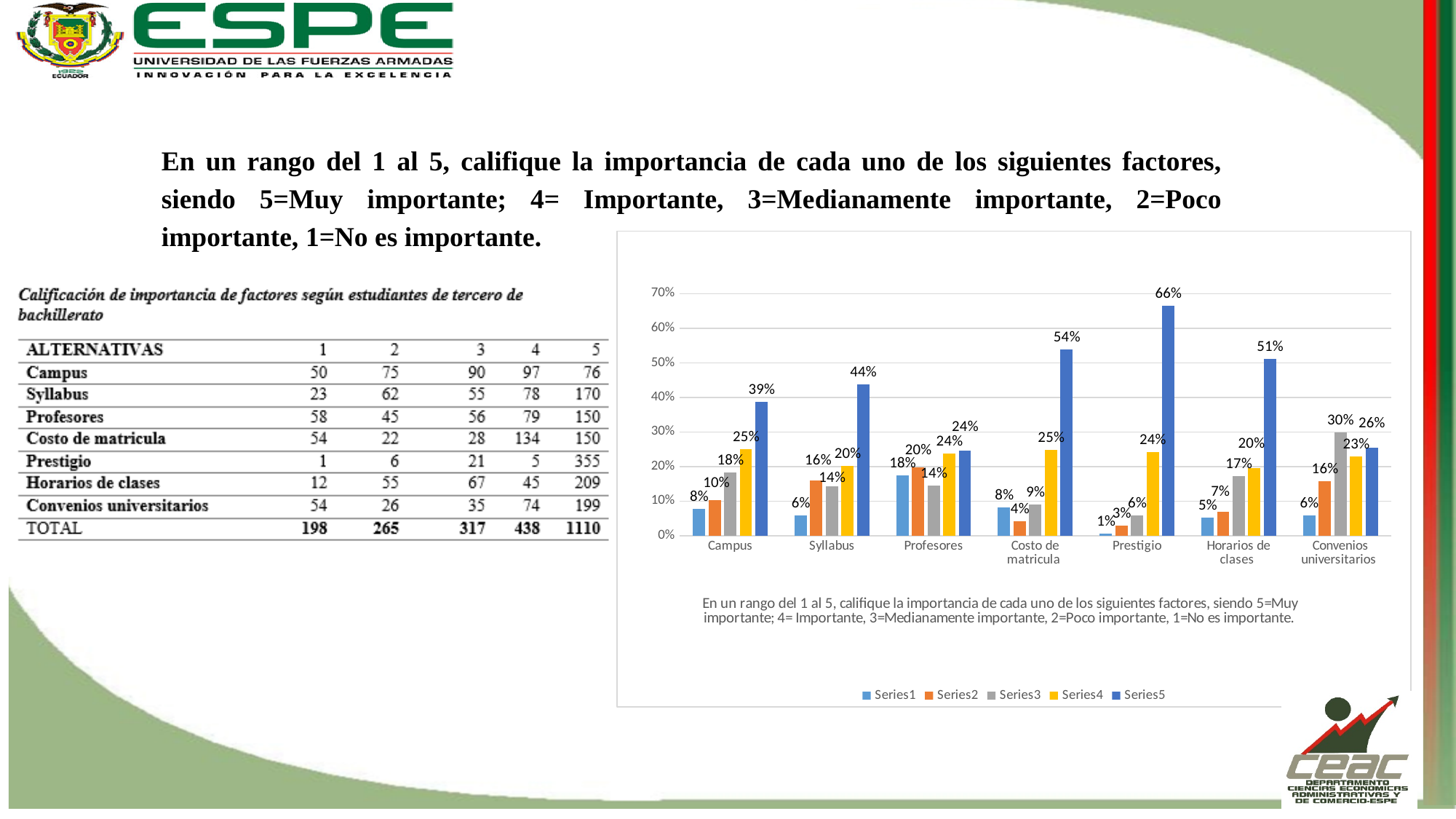
What is the value of Series5 for Prestigio? 66% Which is larger: Series5 for Syllabus or Series5 for Horarios de clases? Horarios de clases What is the difference between the Series5 values for Costo de matricula and Campus? 15% What is the value of Series3 for Convenios universitarios? 30% Which category has the lowest Series1 value? Prestigio Which category has the highest Series5 value? Prestigio Is the Series5 value for Costo de matricula greater or less than 50%? greater How many series does the chart legend list? 5 What colour are the Series5 bars in the chart? blue How many categories are shown on the x axis of the chart? 7 What type of chart is shown on the slide? bar chart What is the value of Series1 for Profesores? 18%